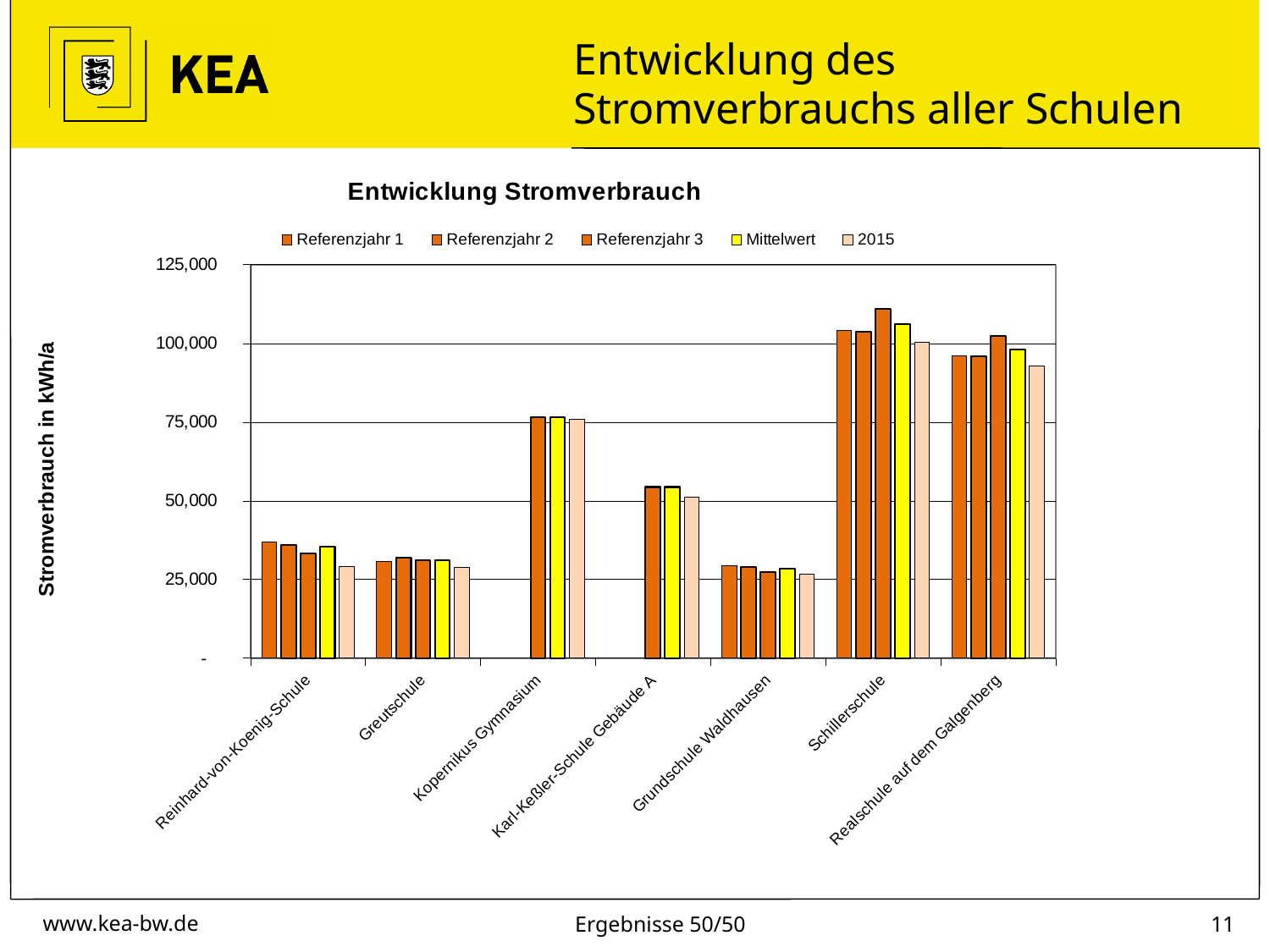
Is the Referenzjahr 3 value for Schillerschule greater or less than 100,000? greater Which has the larger Mittelwert value, Kopernikus Gymnasium or Karl-Keßler-Schule Gebäude A? Kopernikus Gymnasium Is the 2015 value for Realschule auf dem Galgenberg greater or less than 100,000? less Is the 2015 value for Grundschule Waldhausen greater or less than 50,000? less How many schools (categories) are shown on the x axis of the chart? 7 Which school has the highest electricity consumption in the chart? Schillerschule How many series does the chart legend list? 5 Which has the larger Referenzjahr 3 value, Schillerschule or Realschule auf dem Galgenberg? Schillerschule What kind of chart is shown on the slide? bar chart What is the label of the chart's y axis? Stromverbrauch in kWh/a